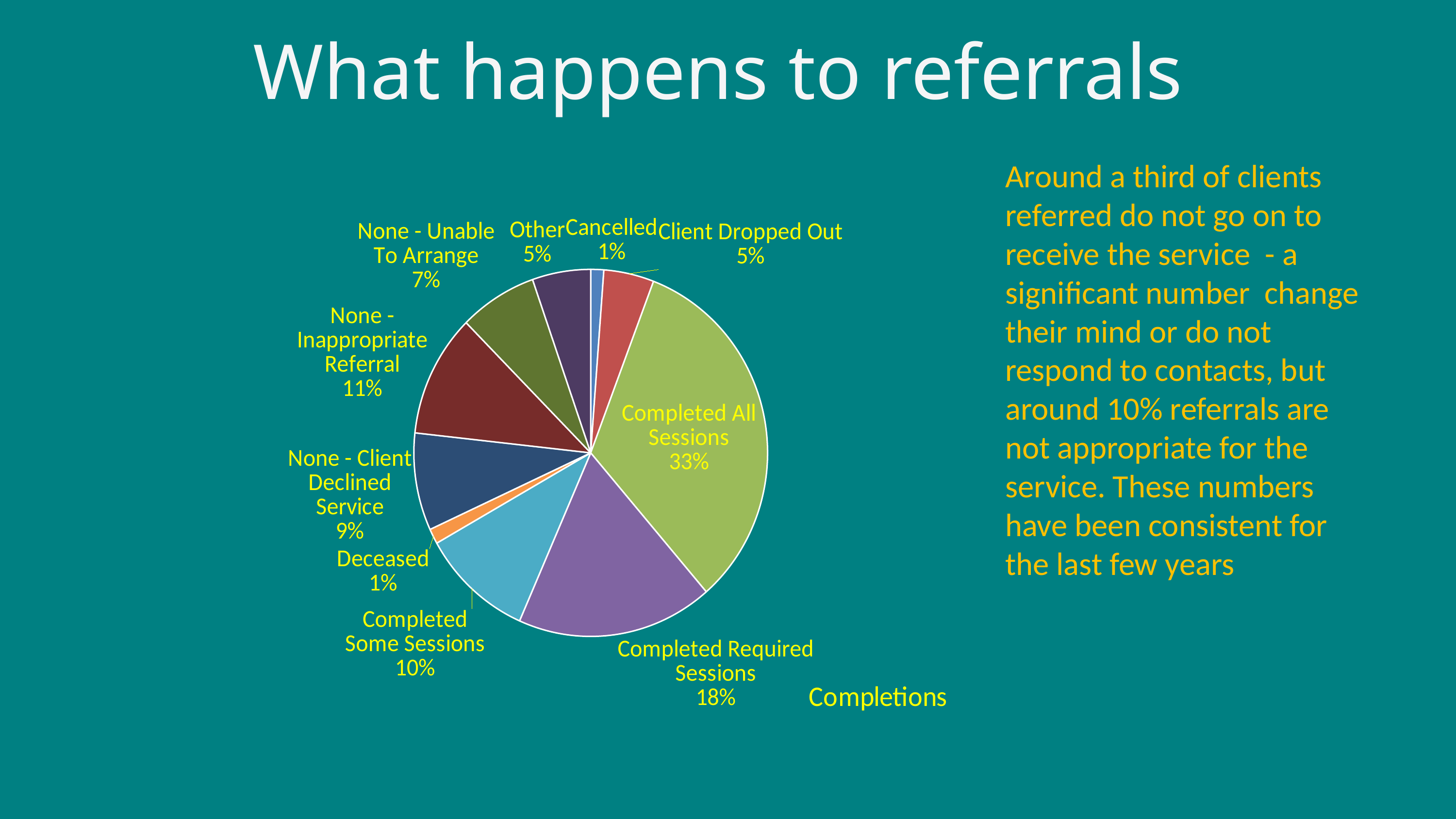
What share of the pie does Completed All Sessions represent? 33% What is the combined share of Deceased and Cancelled? 2% What is the value for None - Client Declined Service? 9% How many categories are shown in the pie chart? 10 What is the difference between Completed All Sessions and Completed Required Sessions? 15% Which is larger, None - Unable To Arrange or Completed Some Sessions? Completed Some Sessions What kind of chart is shown on the slide? Pie chart What is the value shown for Completed Required Sessions? 18% What is the value shown for Client Dropped Out? 5% What percentage is labelled for None - Inappropriate Referral? 11% What is the title of the chart? Completions Which category has the largest slice of the pie? Completed All Sessions